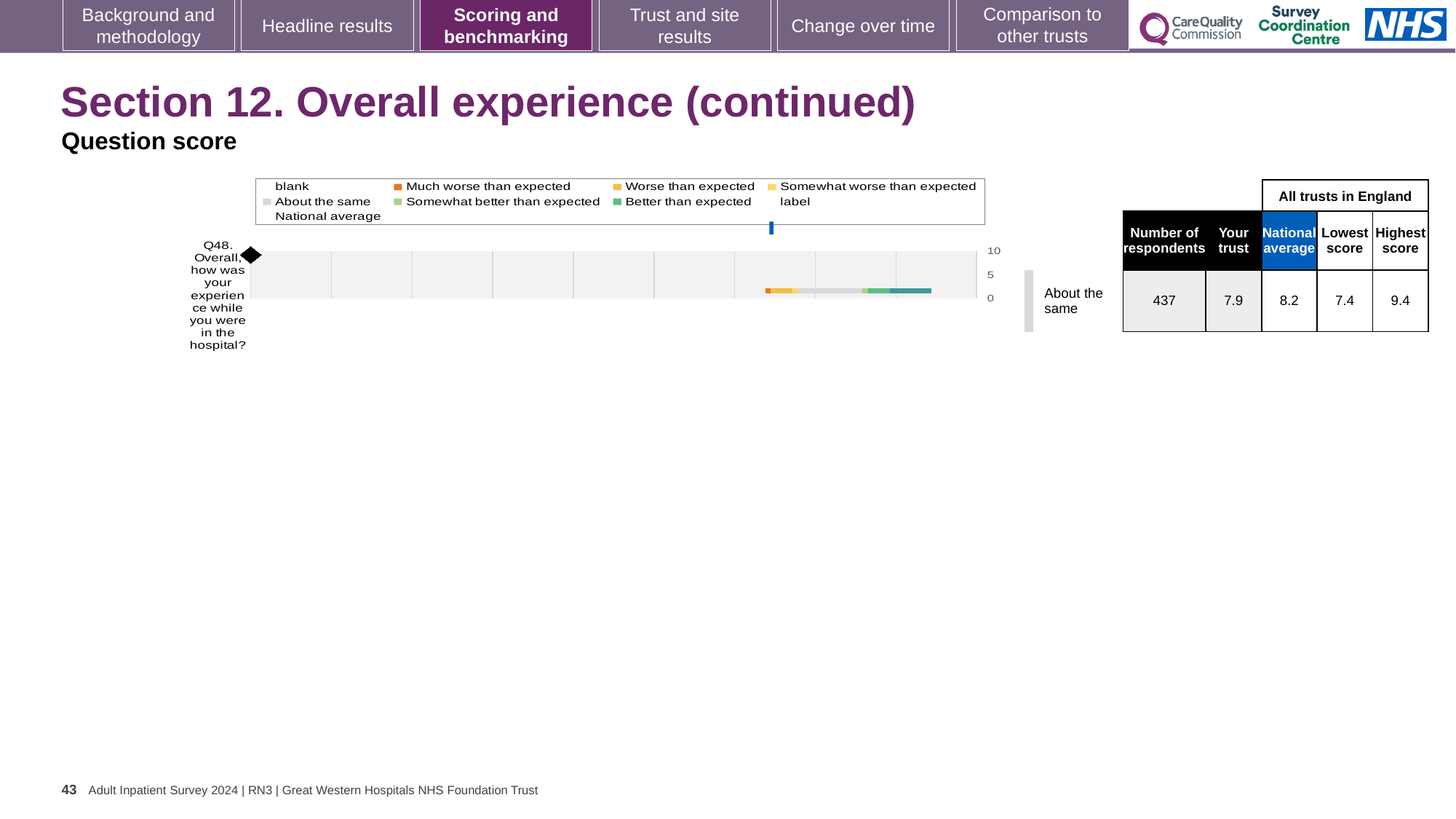
How many respondents are listed for Q48 in the table next to the chart? 437 Which survey question is plotted on the chart? Q48. Overall, how was your experience while you were in the hospital? What is the highest value shown on the chart's score axis? 10 How many survey questions are plotted on the chart? 1 What benchmarking category is the trust's Q48 score placed in? About the same What is the highest score among all trusts in England for Q48? 9.4 What kind of chart is used to show the Q48 question score? bar chart What is the 'Your trust' score for Q48 in the table next to the chart? 7.9 What is the difference between the highest score and the lowest score for Q48? 2.0 For Q48, which is larger: the 'Your trust' score or the national average? National average What is the lowest score among all trusts in England for Q48? 7.4 What is the national average score for Q48 in the table next to the chart? 8.2